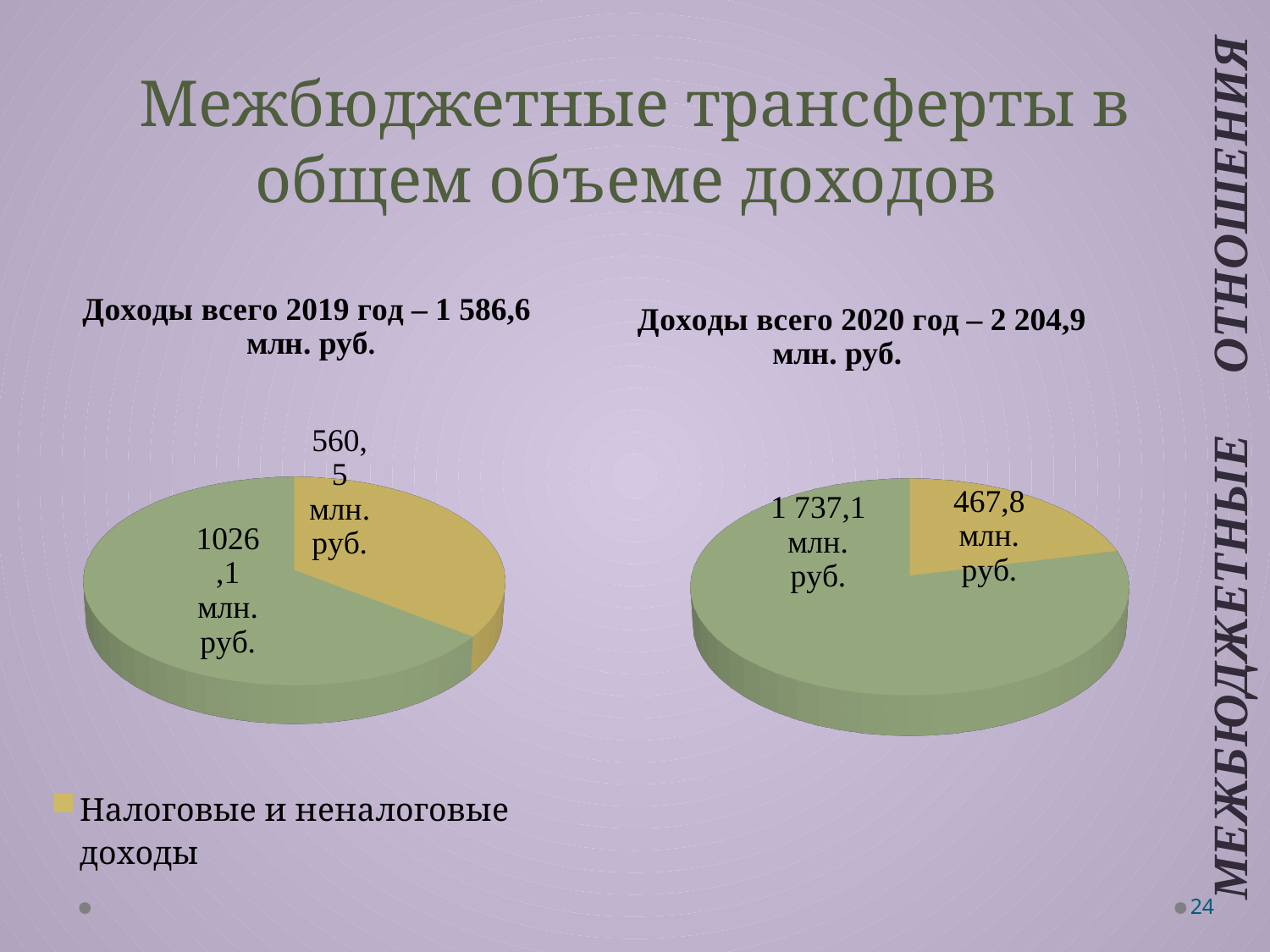
In the 2019 pie chart (left), which slice is larger: the yellow 'Налоговые и неналоговые доходы' slice or the green slice? The green slice In the chart titled 'Доходы всего 2019 год – 1 586,6 млн. руб.', what is the value of the green slice? 1026,1 млн. руб. By how much did 'Налоговые и неналоговые доходы' decrease from the 2019 chart to the 2020 chart? 92,7 млн. руб. Is the value of 'Налоговые и неналоговые доходы' larger in the 2019 chart or in the 2020 chart? 2019 In the chart titled 'Доходы всего 2019 год – 1 586,6 млн. руб.', what is the value of the 'Налоговые и неналоговые доходы' (yellow) slice? 560,5 млн. руб. How many slices does each pie chart on the slide have? 2 In the chart titled 'Доходы всего 2020 год – 2 204,9 млн. руб.', what is the value of the green slice? 1 737,1 млн. руб. In the chart titled 'Доходы всего 2020 год – 2 204,9 млн. руб.', what is the value of the 'Налоговые и неналоговые доходы' (yellow) slice? 467,8 млн. руб. What kind of chart is used on this slide for the 2019 and 2020 income data? Pie chart In the 2020 pie chart (right), what is the difference between the green slice and the yellow 'Налоговые и неналоговые доходы' slice? 1 269,3 млн. руб. How many entries does the legend on the slide list? 1 In the 2019 pie chart (left), what is the difference between the green slice and the yellow 'Налоговые и неналоговые доходы' slice? 465,6 млн. руб.